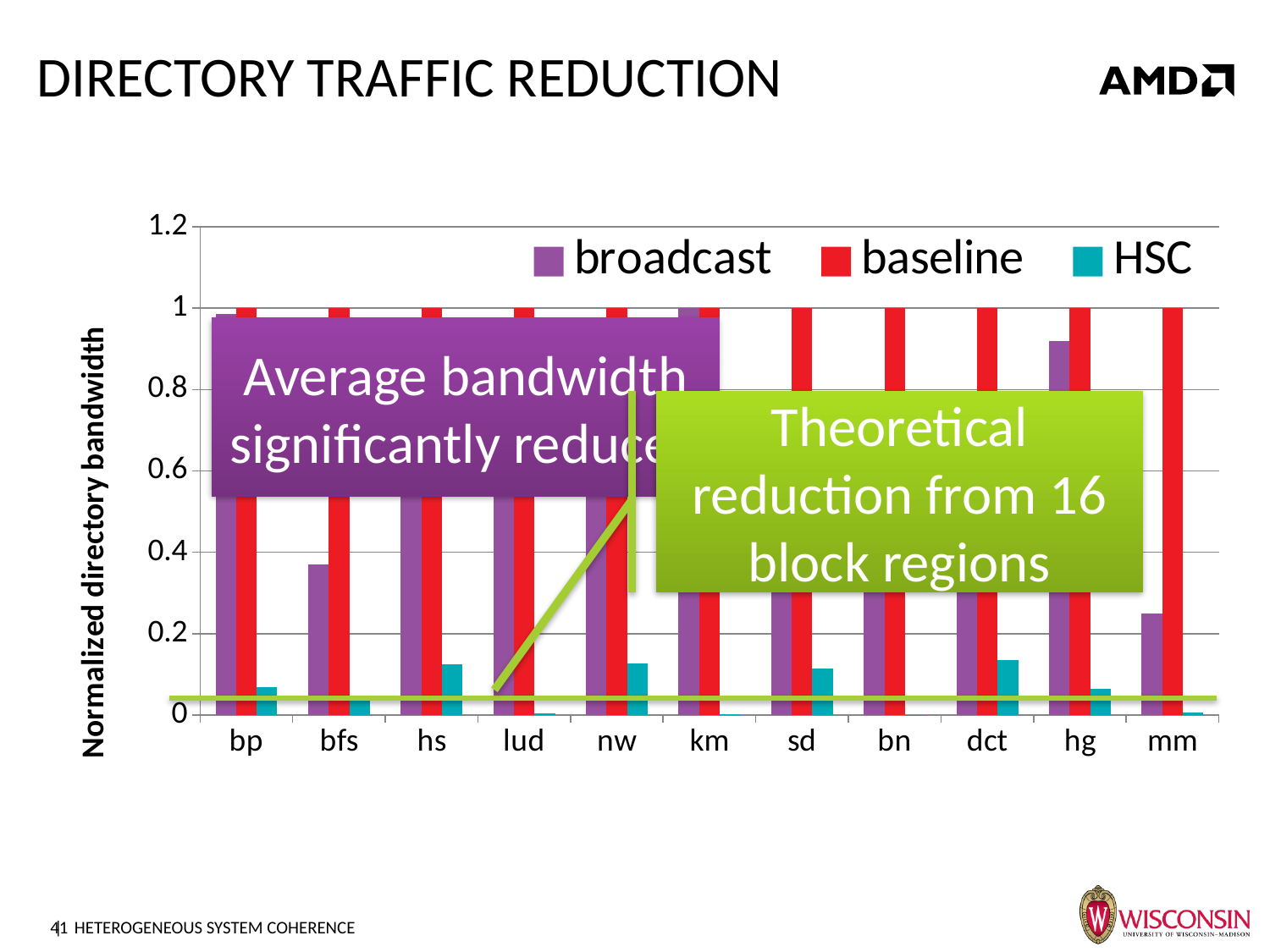
Is the broadcast value for hg greater or less than 0.8? greater Is the HSC value for dct greater or less than 0.2? less For bp, which is larger, the broadcast value or the HSC value? broadcast What is the baseline value for sd? 1 How many series does the legend list? 3 Is the broadcast value for mm greater or less than 0.4? less What is the baseline value for mm? 1 What kind of chart is shown on the slide? bar chart How many categories are shown along the x axis? 11 What is the title of the y axis? Normalized directory bandwidth Which category has the lowest broadcast value? mm